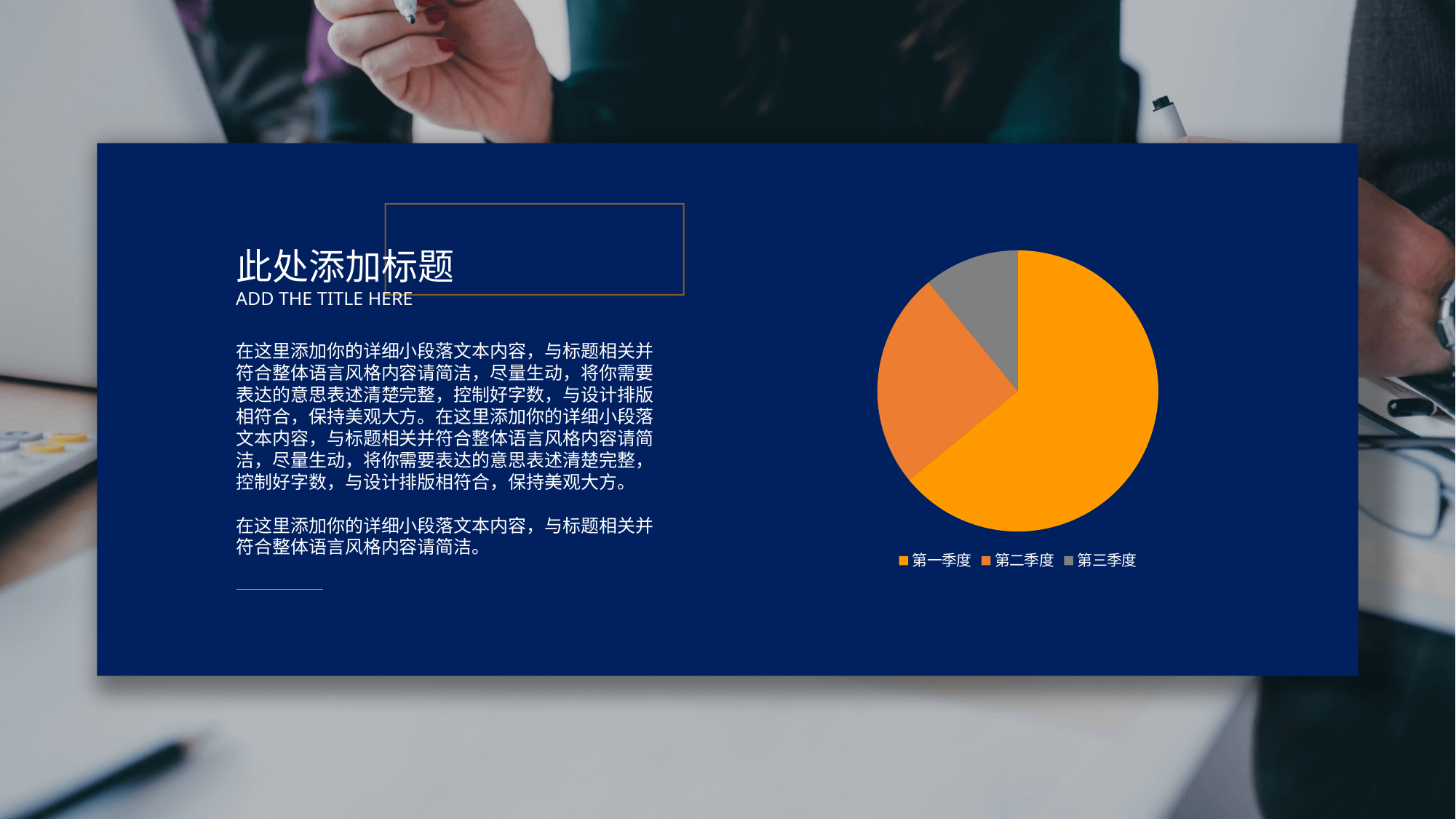
What kind of chart is shown on the slide? Pie chart What are the three legend entries of the pie chart, in order? 第一季度, 第二季度, 第三季度 What colour is the 第三季度 slice in the pie chart? Grey How many slices does the pie chart have? 3 Which category has the largest slice in the pie chart? 第一季度 Which slice is larger in the pie chart, 第一季度 or 第二季度? 第一季度 Which category has the smallest slice in the pie chart? 第三季度 Which slice is larger in the pie chart, 第二季度 or 第三季度? 第二季度 How many entries does the legend of the pie chart list? 3